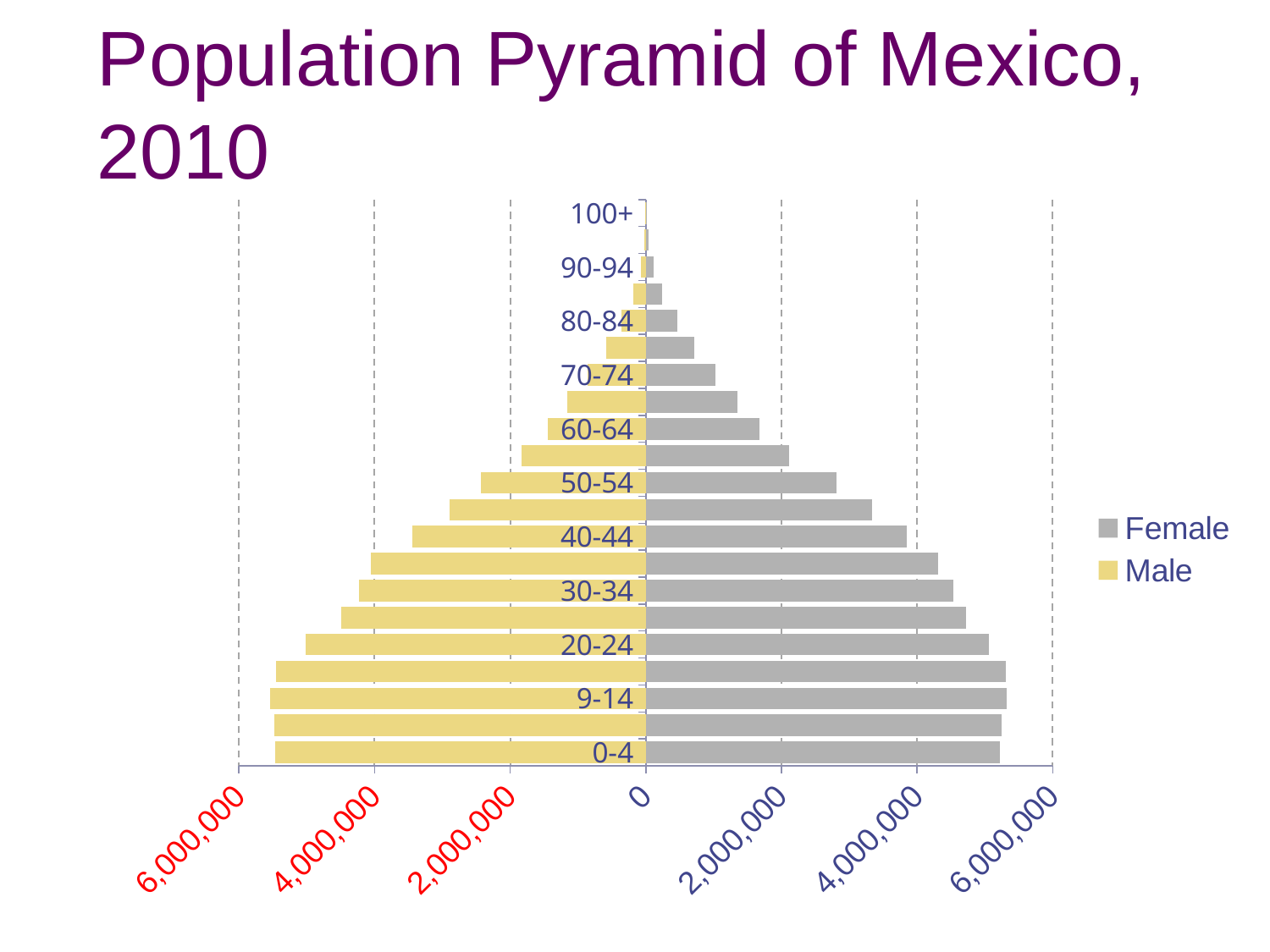
Is the Male value for the 0-4 age group greater or less than 4,000,000? greater What is the title of the chart? Population Pyramid of Mexico, 2010 Which is larger, the Male value for 0-4 or the Male value for 50-54? 0-4 Is the Male value for the 60-64 age group greater or less than 2,000,000? less Which is larger, the Female value for 20-24 or the Female value for 60-64? 20-24 Which age group has the smallest Male value? 100+ How many series does the legend list? 2 Which colour represents the Male series in the legend? yellow What kind of chart is shown on the slide? bar chart Is the Female value for the 50-54 age group greater or less than 4,000,000? less Do the Female values rise or fall as the age group increases from 20-24 to 100+? fall